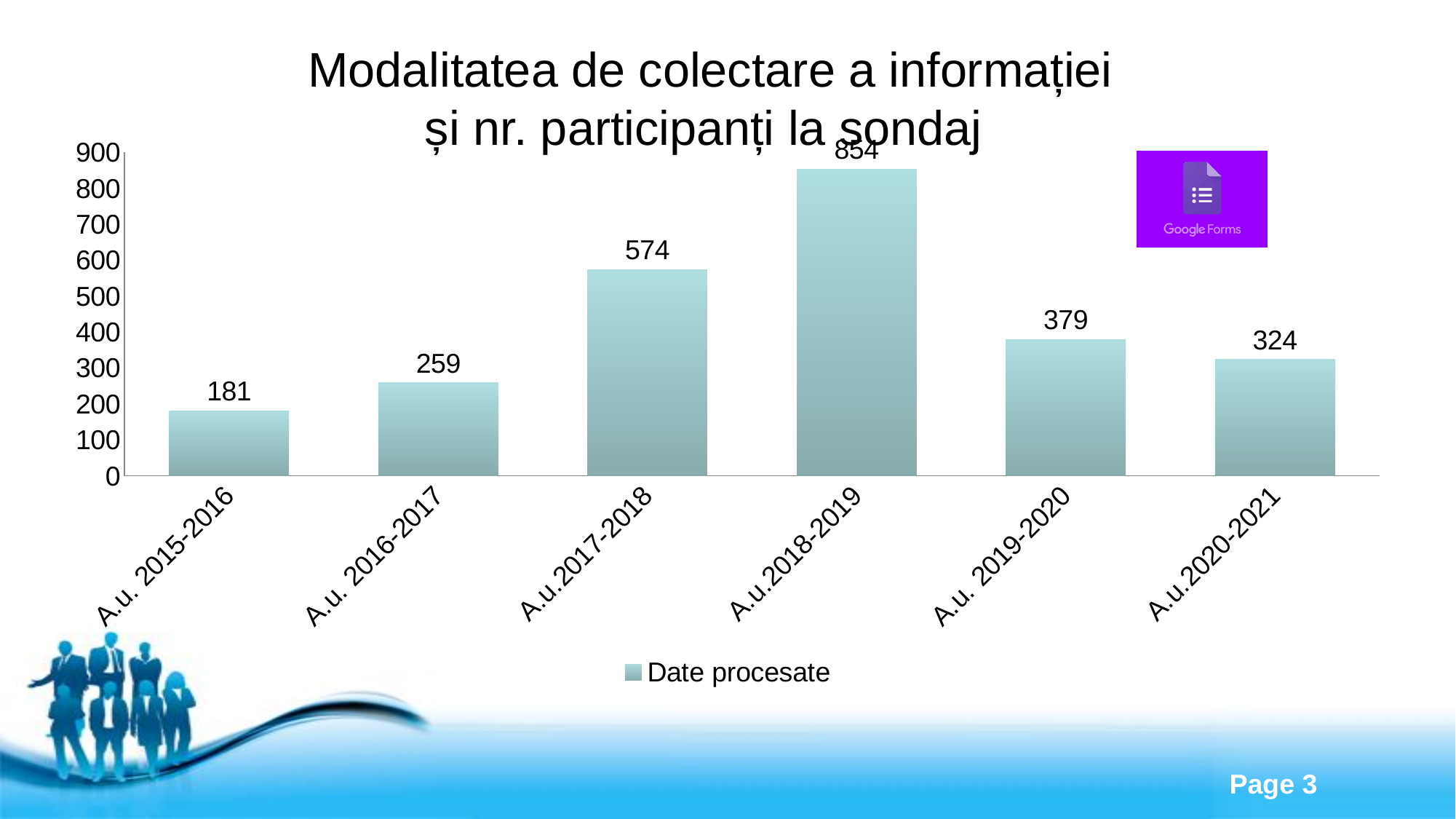
Which category has the lowest value? A.u. 2015-2016 What is the name of the series in the legend? Date procesate How many categories are shown on the x axis? 6 Which is larger, the value for A.u. 2019-2020 or A.u.2020-2021? A.u. 2019-2020 What is the difference between the values for A.u.2018-2019 and A.u.2017-2018? 280 How many series does the legend list? 1 What is the value for A.u.2018-2019? 854 What is the value for A.u.2020-2021? 324 Which category has the highest value? A.u.2018-2019 What is the value for A.u. 2015-2016? 181 What kind of chart is shown? bar chart Is the value for A.u. 2016-2017 greater or less than 300? less